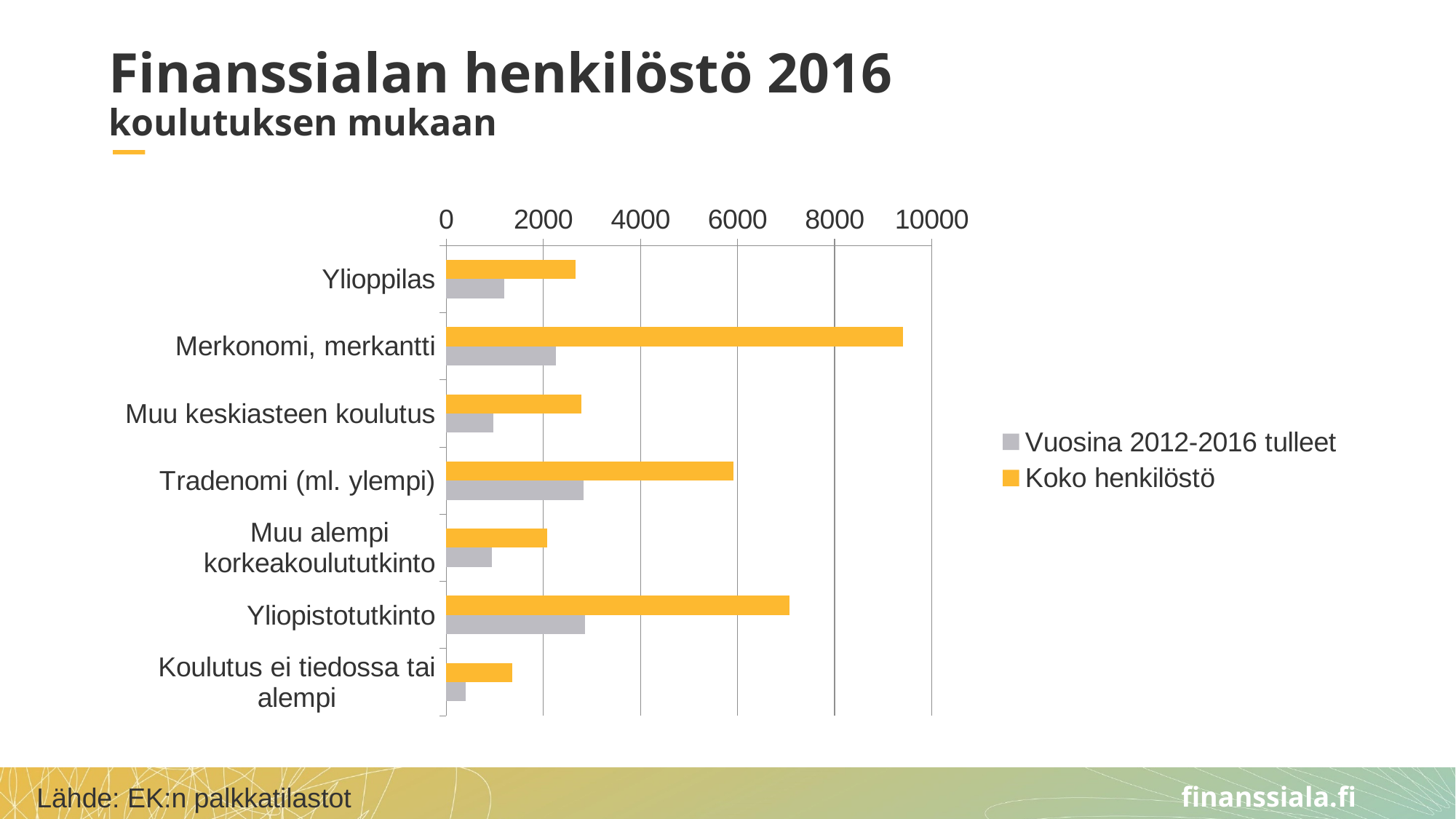
Which category has the lowest value for Vuosina 2012-2016 tulleet? Koulutus ei tiedossa tai alempi Which category has the lowest value for Koko henkilöstö? Koulutus ei tiedossa tai alempi How many series does the legend list? 2 Is the Vuosina 2012-2016 tulleet value for Ylioppilas greater or less than 2000? less For Koko henkilöstö, which is larger: Yliopistotutkinto or Tradenomi (ml. ylempi)? Yliopistotutkinto What kind of chart is shown on the slide? bar chart Is the Koko henkilöstö value for Yliopistotutkinto greater or less than 6000? greater Which colour represents Koko henkilöstö in the legend? orange Is the Koko henkilöstö value for Koulutus ei tiedossa tai alempi greater or less than 2000? less Which category has the highest value for Koko henkilöstö? Merkonomi, merkantti How many education categories are shown on the chart? 7